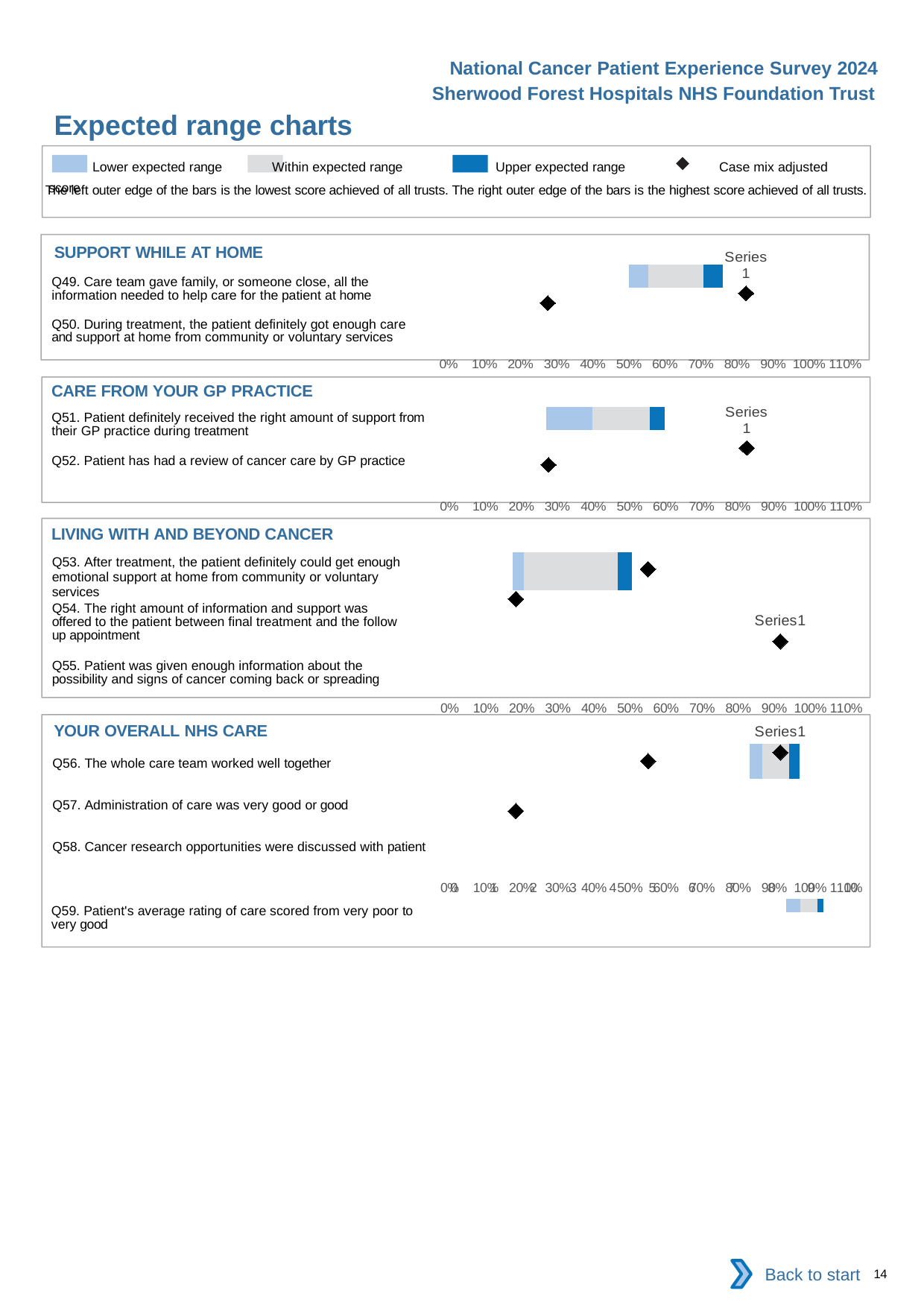
How many entries does the legend at the top of the slide list? 4 According to the legend, what does the diamond marker represent? Case mix adjusted score How many questions are listed in the YOUR OVERALL NHS CARE chart? 4 How many questions are listed in the CARE FROM YOUR GP PRACTICE chart? 2 In the YOUR OVERALL NHS CARE chart, is the case mix adjusted score marker on the Q56 row greater or less than 50%? greater In the CARE FROM YOUR GP PRACTICE chart, is the case mix adjusted score marker on the Q52 row greater or less than 50%? less How many questions are listed in the LIVING WITH AND BEYOND CANCER chart? 3 In the YOUR OVERALL NHS CARE chart, is the case mix adjusted score marker on the Q57 row greater or less than 30%? less What is the highest percentage tick shown on the x axis of the expected range charts? 110% What kind of chart is used in the expected range charts on this slide? Bar chart